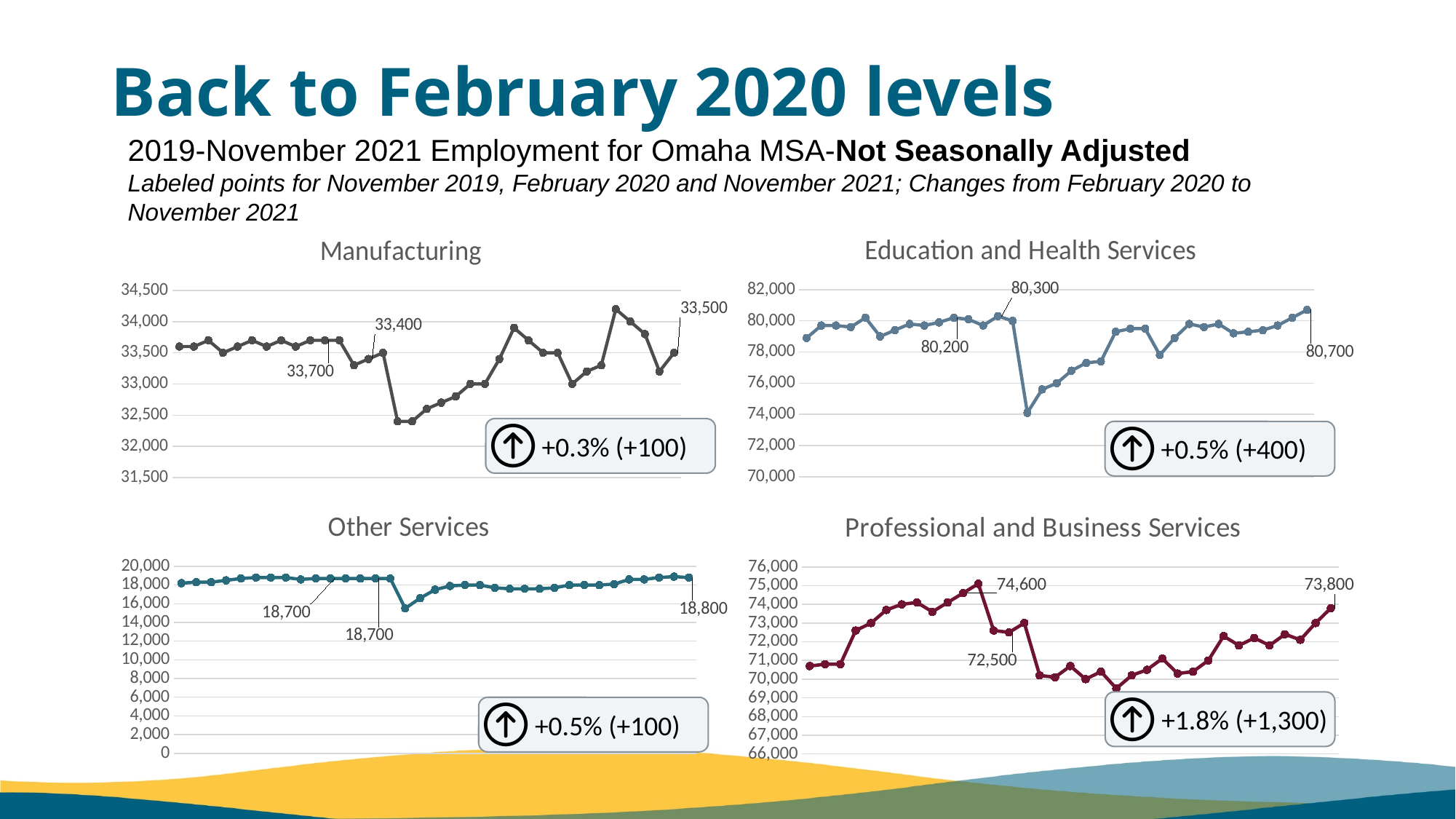
In the Professional and Business Services chart, what is the labeled value for February 2020? 72,500 In the Education and Health Services chart, what is the labeled value for November 2021? 80,700 In the Education and Health Services chart, what is the difference between the November 2021 value (80,700) and the February 2020 value (80,300)? 400 In the Manufacturing chart, what is the labeled value for February 2020? 33,400 What percentage change from February 2020 to November 2021 is shown in the callout on the Professional and Business Services chart? +1.8% (+1,300) In the Education and Health Services chart, is the lowest point of the line greater or less than 76,000? less In the Professional and Business Services chart, what is the difference between the November 2019 value (74,600) and the February 2020 value (72,500)? 2,100 In the Other Services chart, what is the labeled value for November 2019? 18,700 In the Professional and Business Services chart, which labeled value is larger: November 2019 or November 2021? November 2019 What kind of chart is used for Other Services? Line chart In the Manufacturing chart, what is the labeled value for November 2021? 33,500 In the Manufacturing chart, is the lowest point of the line greater or less than 32,500? less